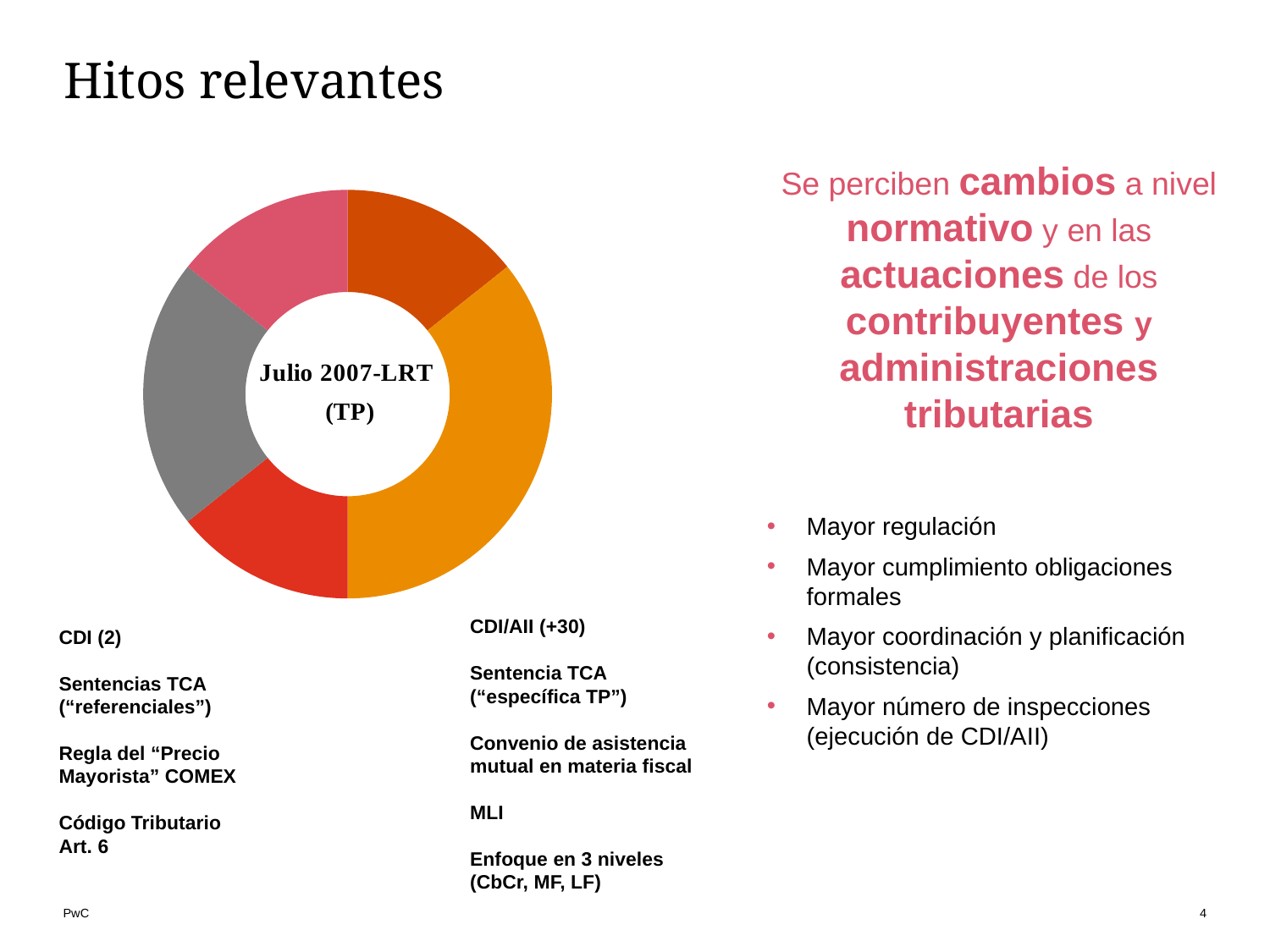
Is the orange slice of the donut chart larger or smaller than the pink slice? Larger What kind of chart is shown on the left of the slide? Donut (pie) chart Does the donut chart display any data labels or a legend? No Which colour slice of the donut chart is the largest? Orange What text is written in the centre of the donut chart? Julio 2007-LRT (TP) How many slices does the donut chart have? 5